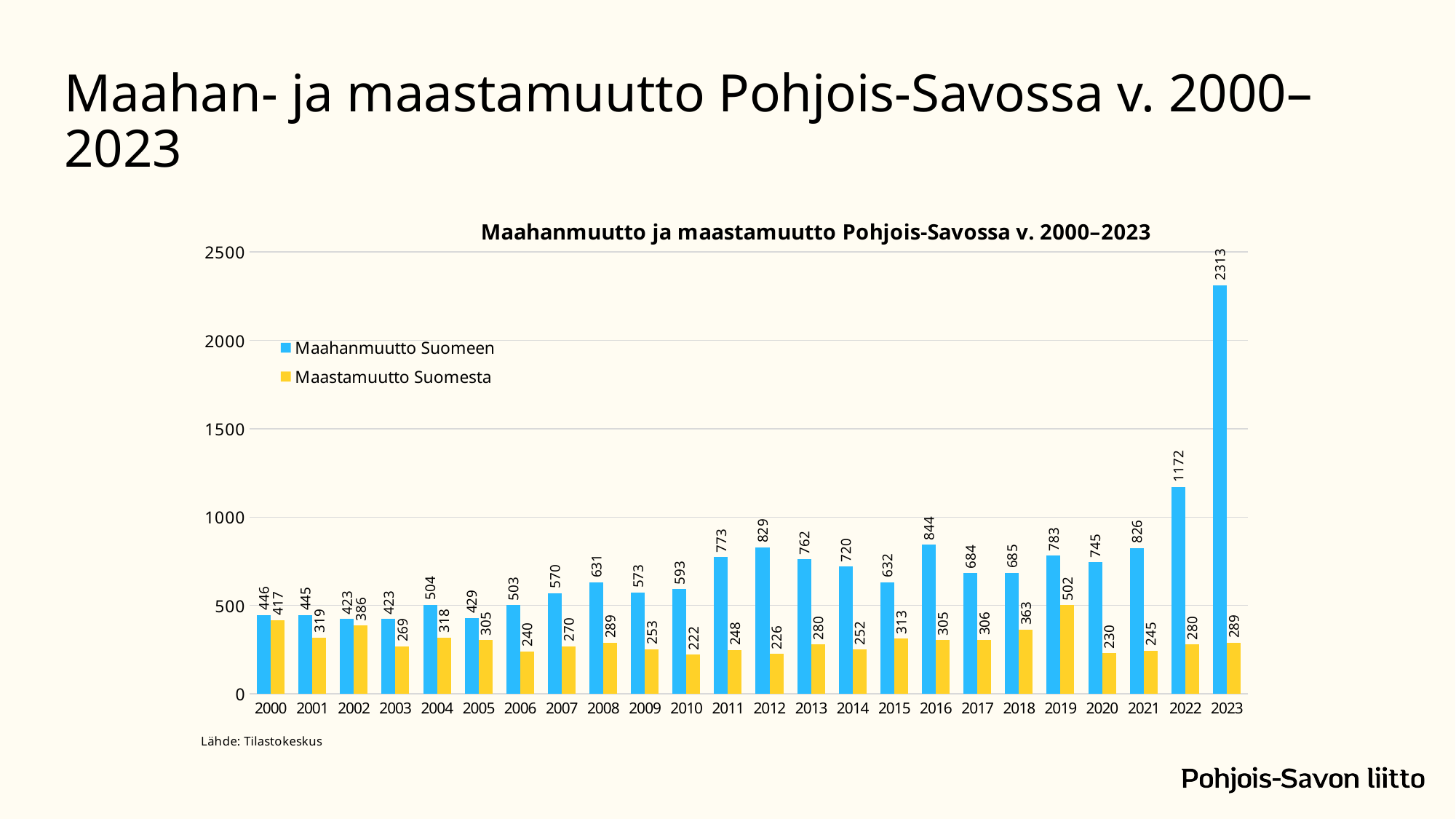
What is the difference between Maahanmuutto Suomeen and Maastamuutto Suomesta in 2022? 892 What is the source cited below the chart? Tilastokeskus Is the value for Maahanmuutto Suomeen in 2022 greater or less than 1000? greater What is the value for Maahanmuutto Suomeen in 2016? 844 Which is larger in 2000: Maahanmuutto Suomeen or Maastamuutto Suomesta? Maahanmuutto Suomeen Which year has the highest value for Maahanmuutto Suomeen? 2023 How many series does the legend list? 2 What is the value for Maastamuutto Suomesta in 2019? 502 What kind of chart is shown on the slide? Bar chart How many years are shown on the x axis? 24 Which year has the lowest value for Maastamuutto Suomesta? 2010 What is the value for Maahanmuutto Suomeen in 2023? 2313